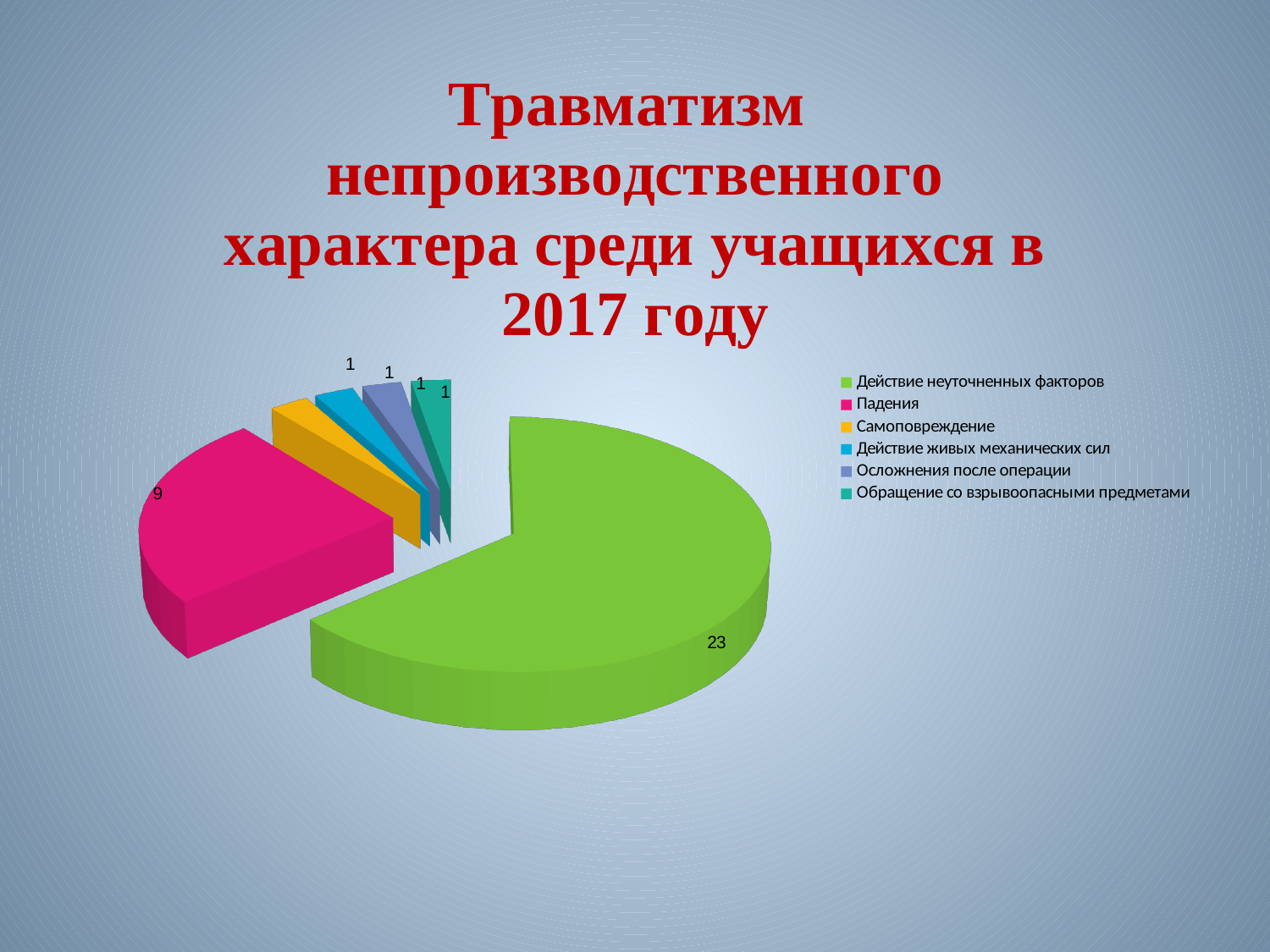
Which is larger, the value for Падения or the value for Осложнения после операции? Падения What is the total of all the slices in the pie chart? 36 What kind of chart is shown on the slide? pie chart What share of the pie does Падения represent? 25% What is the value for Самоповреждение? 1 What is the value for Падения? 9 What is the difference between the values for Действие неуточненных факторов and Падения? 14 What colour is the slice for Падения? pink How many categories have a value of 1? 4 What is the value for Действие неуточненных факторов? 23 How many categories does the pie chart have? 6 Which category has the largest slice of the pie? Действие неуточненных факторов